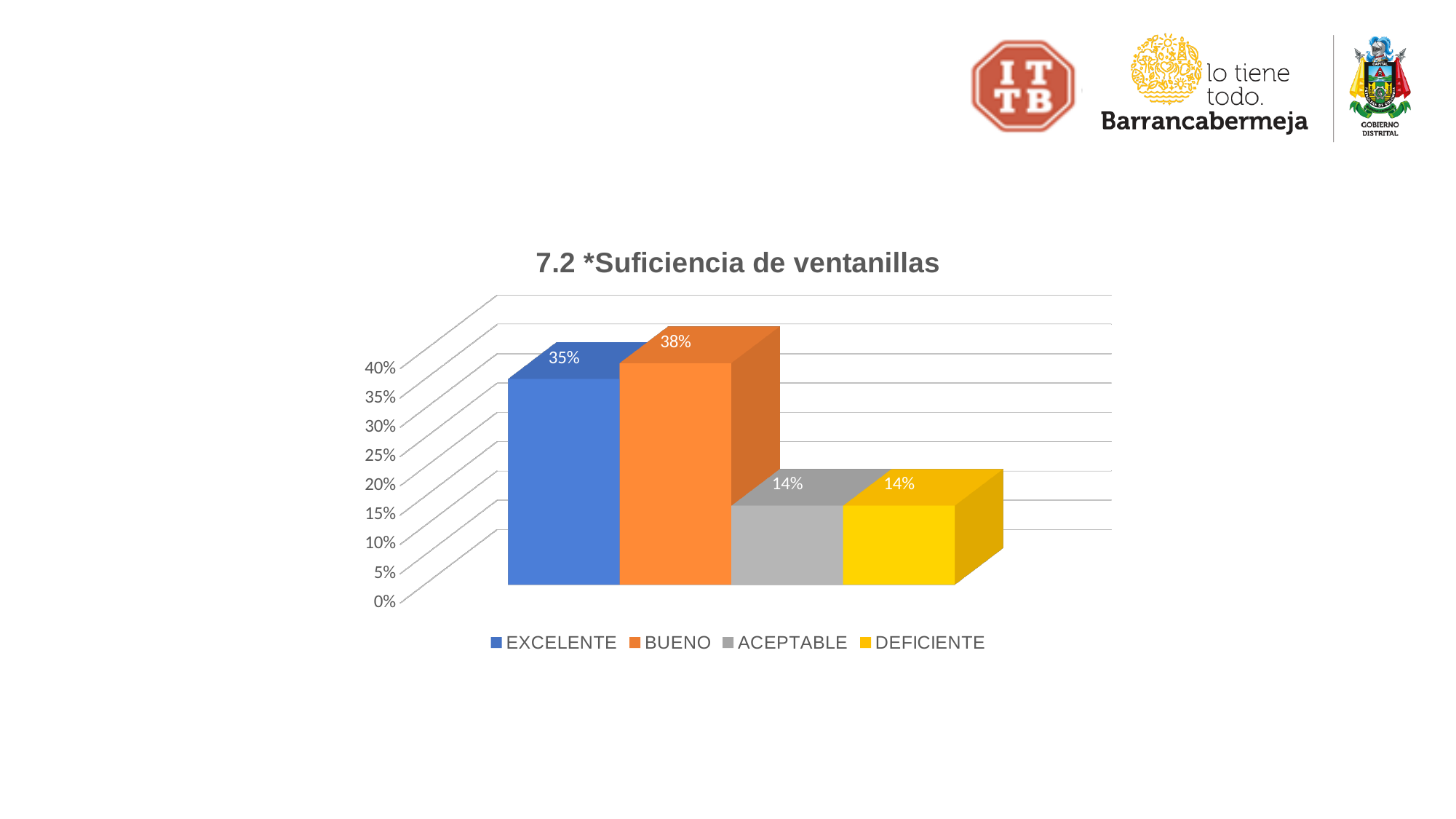
What kind of chart is shown on the slide? Bar chart What is the difference between the values for BUENO and EXCELENTE? 3% Which category has the highest value? BUENO How many entries does the legend list? 4 What is the value for EXCELENTE? 35% What is the difference between the values for EXCELENTE and ACEPTABLE? 21% What is the title of the chart? 7.2 *Suficiencia de ventanillas What is the value for DEFICIENTE? 14% Which is larger, the value for EXCELENTE or the value for DEFICIENTE? EXCELENTE What is the value for BUENO? 38% What is the value for ACEPTABLE? 14% How many categories are shown in the chart? 4